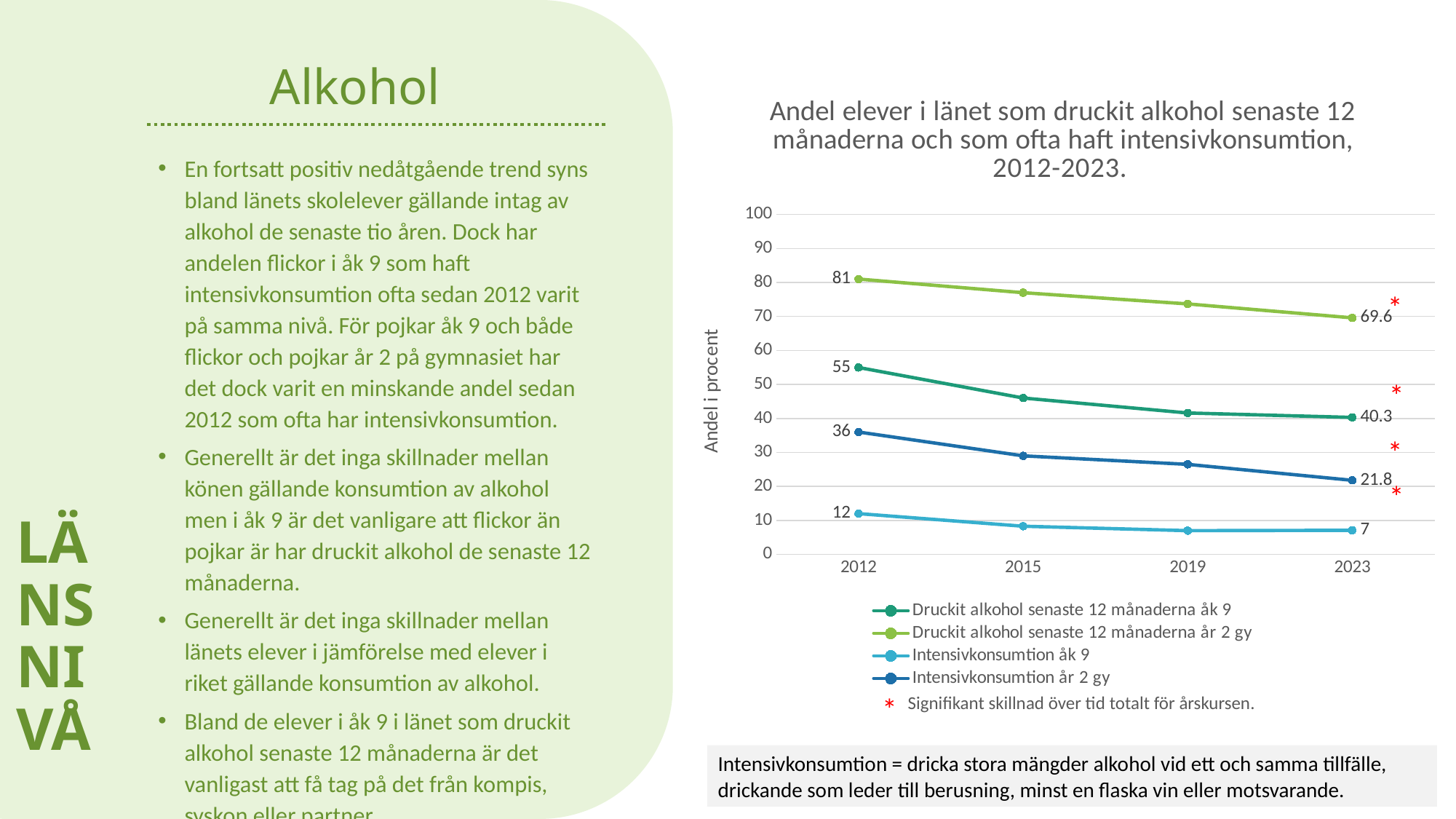
How many series does the legend list? 4 How many years are plotted on the x axis? 4 By how much did 'Druckit alkohol senaste 12 månaderna åk 9' fall from 2012 to 2023? 14.7 Which series has the highest value in 2023? Druckit alkohol senaste 12 månaderna år 2 gy What is the value for 'Druckit alkohol senaste 12 månaderna år 2 gy' in 2012? 81 What is the value for 'Druckit alkohol senaste 12 månaderna åk 9' in 2023? 40.3 Is the value for 'Druckit alkohol senaste 12 månaderna åk 9' in 2015 greater or less than 40? greater What is the value for 'Intensivkonsumtion åk 9' in 2023? 7 What is the value for 'Intensivkonsumtion år 2 gy' in 2012? 36 What type of chart is shown on the slide? line chart Do the values for 'Intensivkonsumtion år 2 gy' rise or fall from 2012 to 2023? fall What is the value for 'Druckit alkohol senaste 12 månaderna år 2 gy' in 2023? 69.6